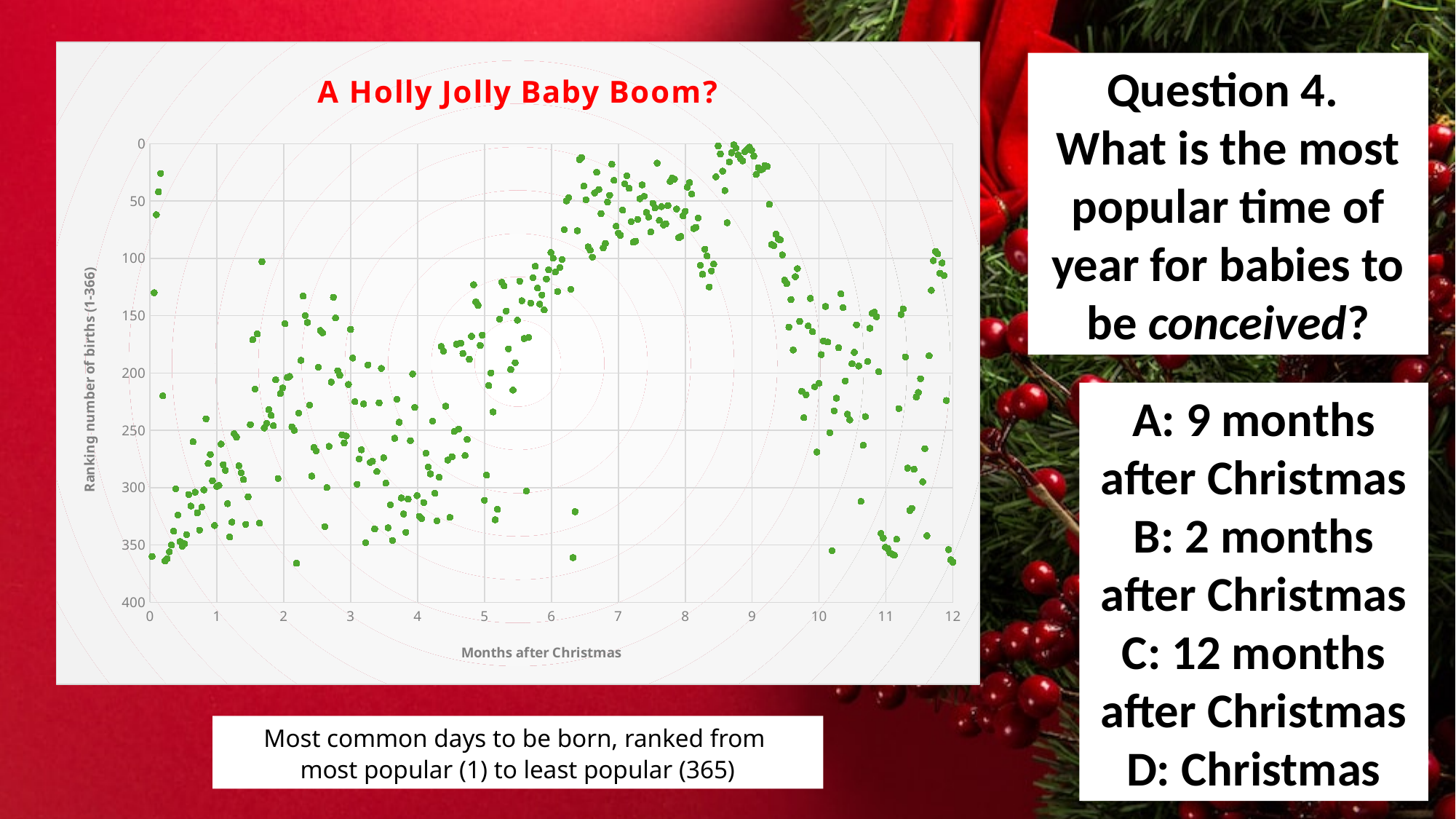
Are most of the points between 0 and 1 months after Christmas ranked greater or less than 250? greater Which has the lower (more popular) ranking numbers: the points around 9 months after Christmas or the points around 1 month after Christmas? 9 months after Christmas Are the points at about 9 months after Christmas ranked greater or less than 50? less What is the highest value shown on the chart's horizontal axis? 12 What kind of chart is shown on the slide? Scatter plot Around which month after Christmas are the points closest to a ranking of 0 (most popular)? 9 What is the title of the chart? A Holly Jolly Baby Boom? What is the highest tick value shown on the chart's vertical axis? 400 What is the label of the chart's vertical axis? Ranking number of births (1-366) Between 6 and 9 months after Christmas, do the ranking numbers generally rise or fall? fall Between 9 and 12 months after Christmas, do the ranking numbers generally rise or fall? rise What is the interval between consecutive tick marks on the vertical axis? 50